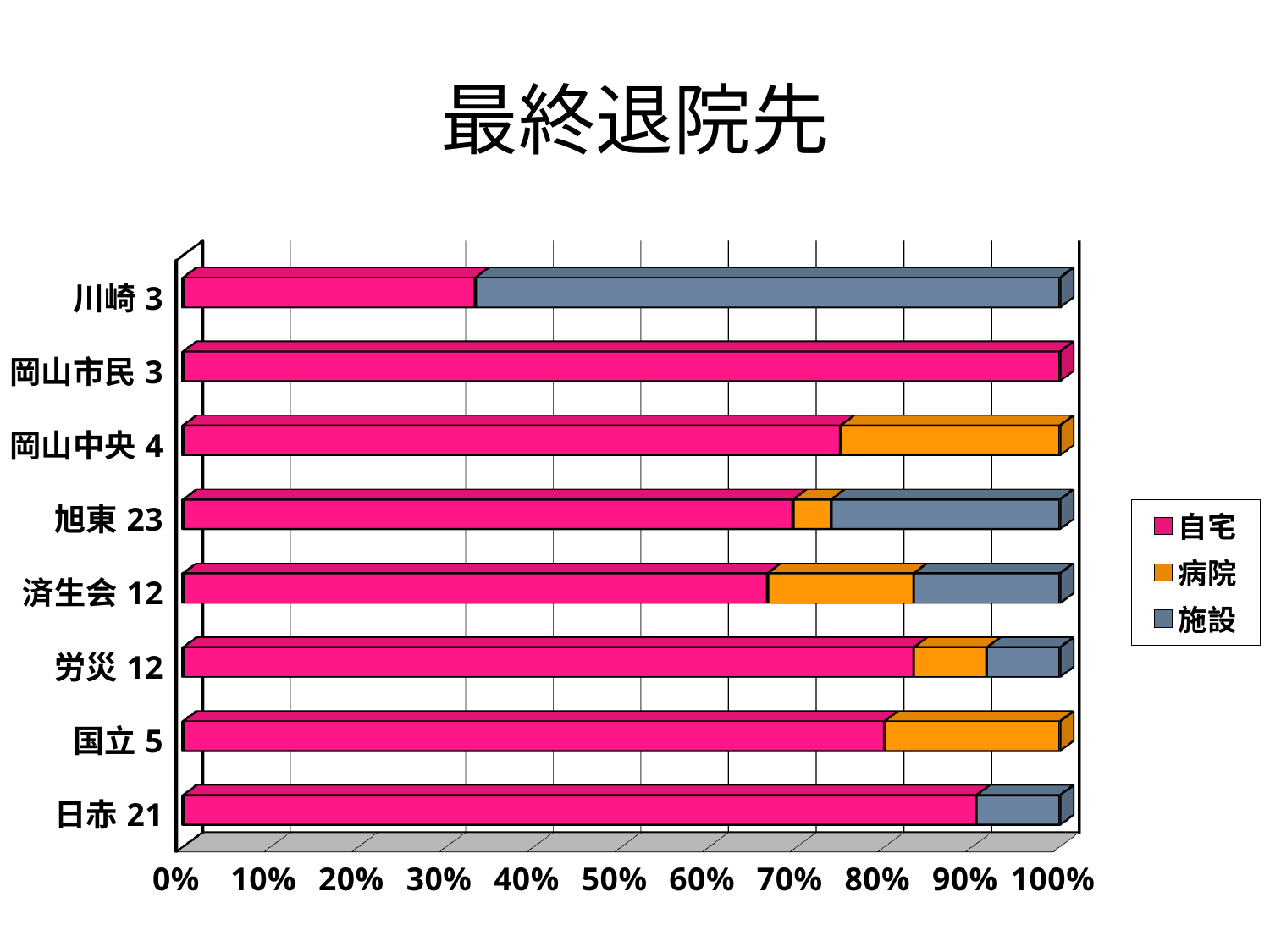
Is the 自宅 share for 川崎 3 greater or less than 40%? less Is the 自宅 share for 日赤 21 greater or less than 80%? greater How many series does the legend list? 3 Which category has the highest share for 自宅? 岡山市民 3 Which legend entry is shown in orange? 病院 Which has the larger 自宅 share, 岡山中央 4 or 済生会 12? 岡山中央 4 How many categories (hospitals) are shown on the vertical axis? 8 Which has the larger 自宅 share, 川崎 3 or 日赤 21? 日赤 21 What is the title of the chart? 最終退院先 What kind of chart is shown on the slide? Stacked bar chart Which category has the lowest share for 自宅? 川崎 3 Is the 自宅 share for 済生会 12 greater or less than 60%? greater